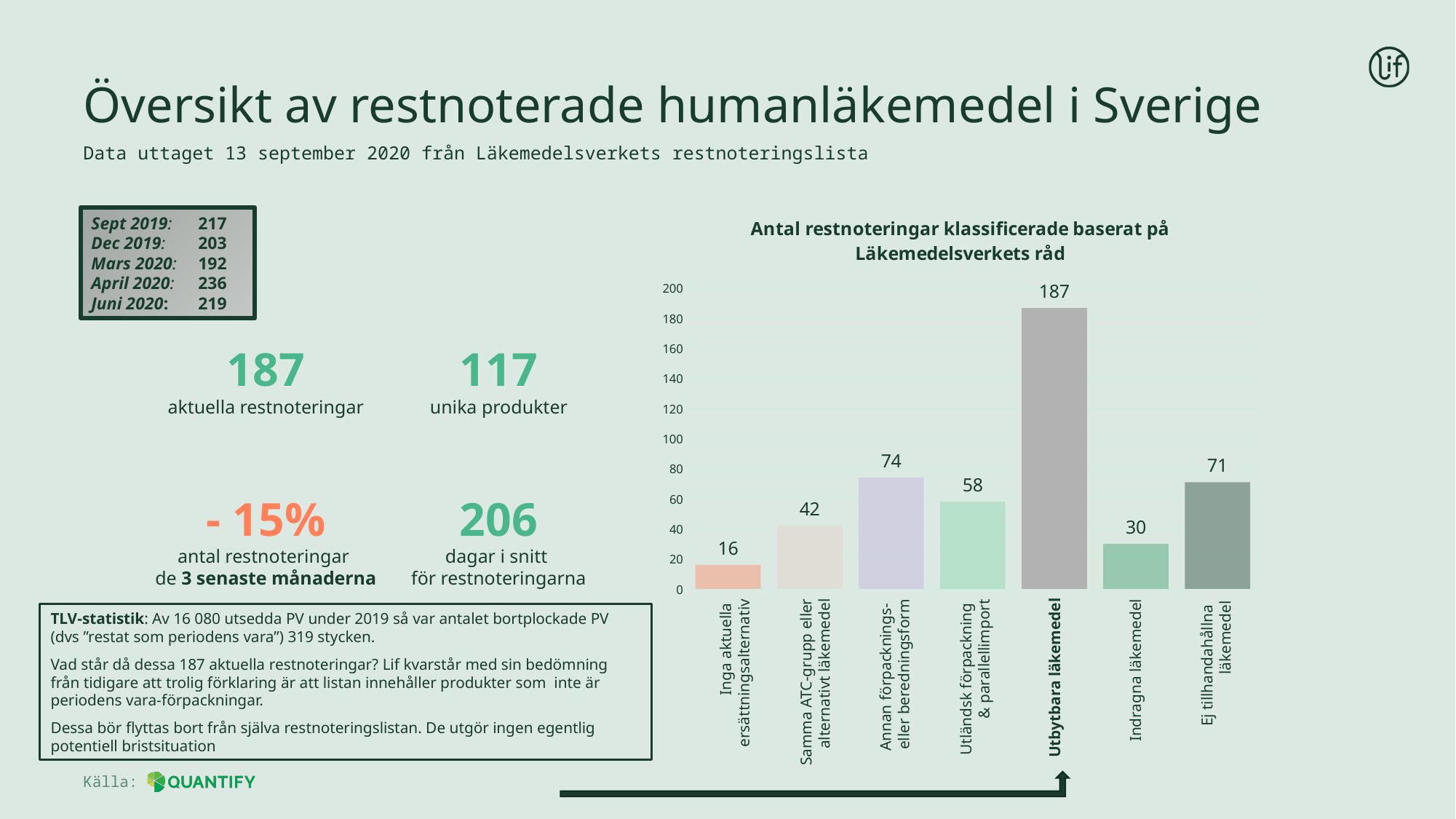
What is the difference between the values for "Utbytbara läkemedel" and "Ej tillhandahållna läkemedel"? 116 What is the value for "Indragna läkemedel" in the chart? 30 Which category has the highest value in the chart? Utbytbara läkemedel What is the value for "Annan förpacknings- eller beredningsform" in the chart? 74 What is the title of the chart? Antal restnoteringar klassificerade baserat på Läkemedelsverkets råd How many categories are shown in the chart? 7 What is the value for "Inga aktuella ersättningsalternativ" in the chart? 16 Is the value for "Ej tillhandahållna läkemedel" greater or less than 60? greater Which is larger: the value for "Samma ATC-grupp eller alternativt läkemedel" or the value for "Utländsk förpackning & parallellimport"? Utländsk förpackning & parallellimport What kind of chart is shown on the slide? bar chart What is the value for "Utbytbara läkemedel" in the chart? 187 Which category has the lowest value in the chart? Inga aktuella ersättningsalternativ